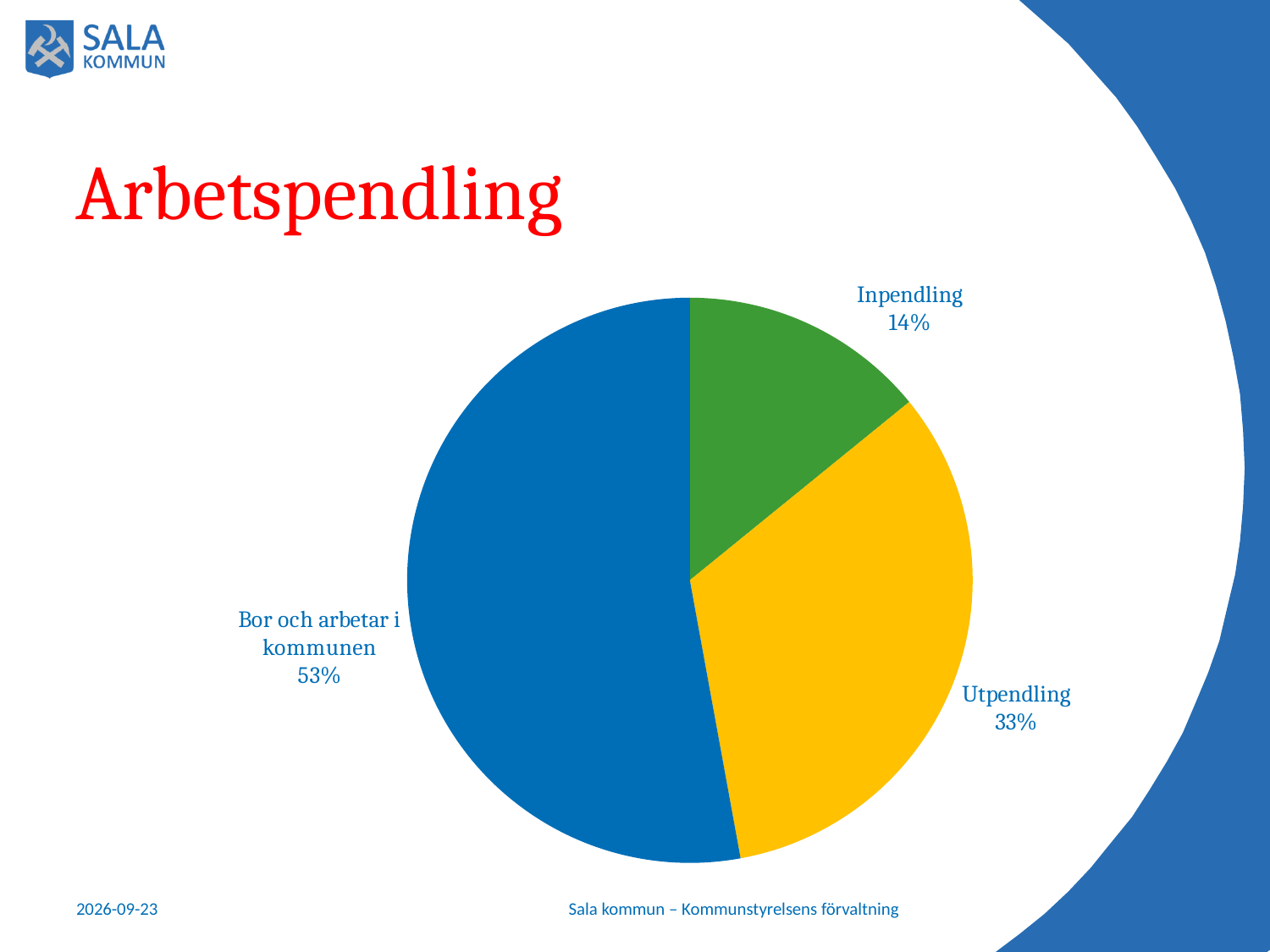
Which slice of the pie is the largest? Bor och arbetar i kommunen Which is larger, Utpendling or Inpendling? Utpendling Which slice of the pie is the smallest? Inpendling What is the difference in percentage points between Bor och arbetar i kommunen and Utpendling? 20 What kind of chart is shown on the slide? pie chart What is the difference in percentage points between Utpendling and Inpendling? 19 What share of the pie is labelled Bor och arbetar i kommunen? 53% What share of the pie is labelled Inpendling? 14% What is the title of the slide containing the pie chart? Arbetspendling What colour is the Utpendling slice? yellow What share of the pie is labelled Utpendling? 33% How many slices does the pie chart have? 3